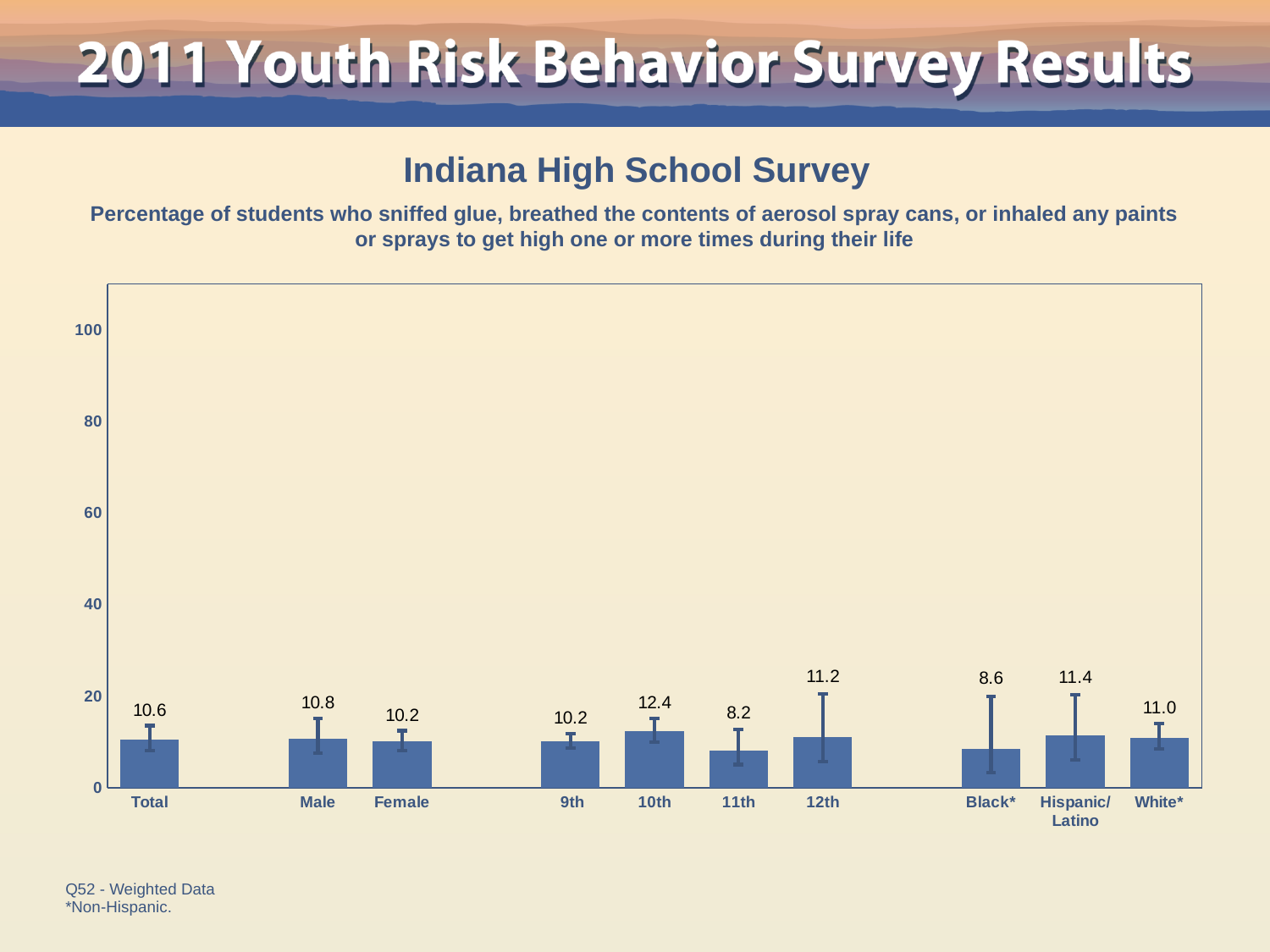
What is the title of the chart? Indiana High School Survey Which category has the highest value? 10th What is the difference between the values for 10th and 11th? 4.2 Is the value for 12th greater or less than 20? less Which category has the lowest value? 11th What is the value for Total? 10.6 What is the value for Hispanic/Latino? 11.4 Which is larger, the value for Black* or the value for White*? White* What is the value for 11th? 8.2 What kind of chart is shown? bar chart How many categories are shown on the x axis? 10 What is the value for Male? 10.8